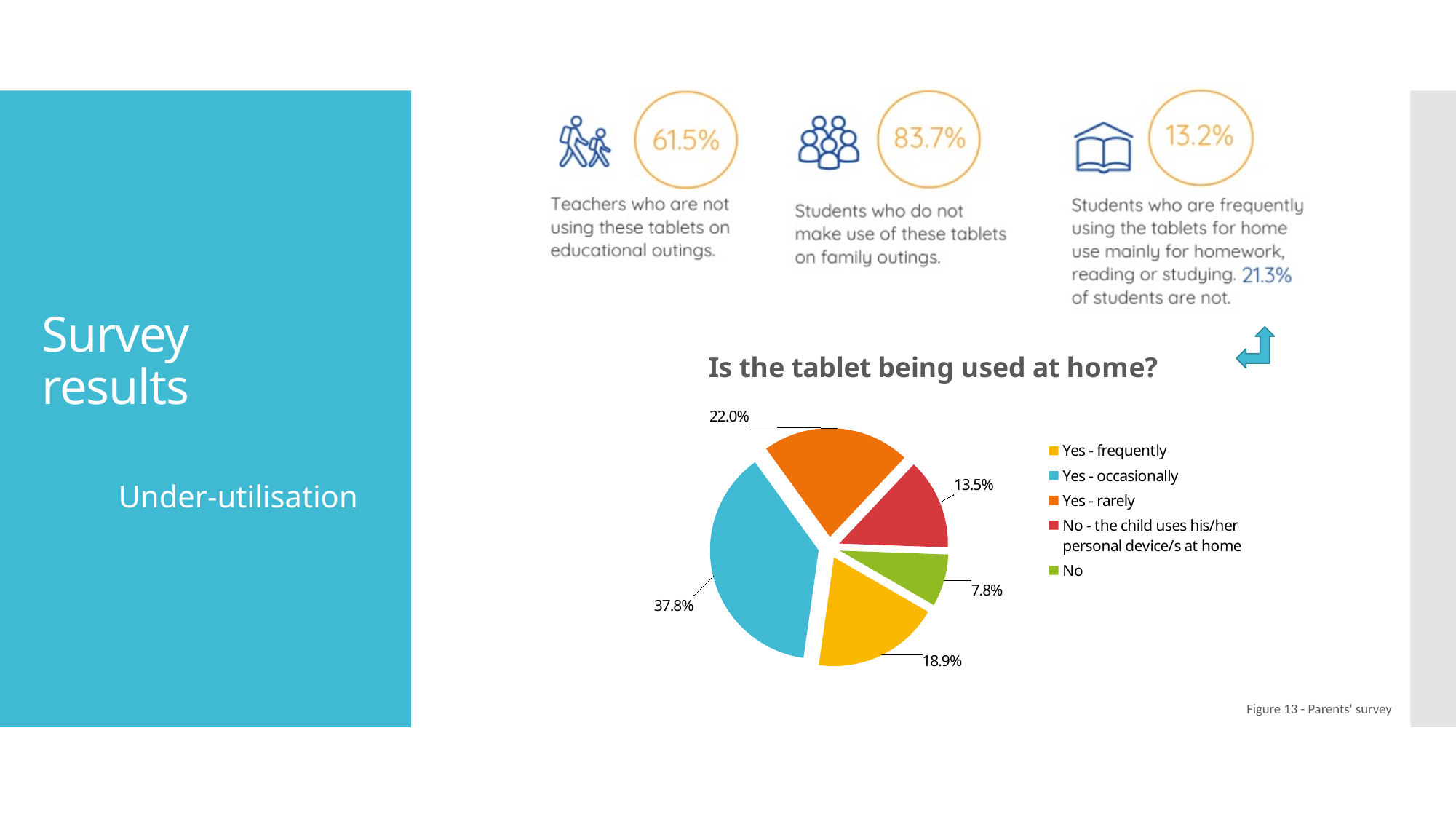
What is the difference between the "Yes - occasionally" and "Yes - rarely" slices in the pie chart? 15.8% What percentage of the pie chart is for "No - the child uses his/her personal device/s at home"? 13.5% What kind of chart is shown under the title "Is the tablet being used at home?"? Pie chart How many categories does the pie chart's legend list? 5 What colour is the "Yes - occasionally" slice in the pie chart? Blue What percentage of the pie chart is for "No"? 7.8% What percentage of the pie chart is for "Yes - frequently"? 18.9% Which category has the largest slice in the pie chart? Yes - occasionally What percentage of the pie chart is for "Yes - occasionally"? 37.8% Which category has the smallest slice in the pie chart? No Which slice is larger in the pie chart: "Yes - frequently" or "No - the child uses his/her personal device/s at home"? Yes - frequently What percentage of the pie chart is for "Yes - rarely"? 22.0%